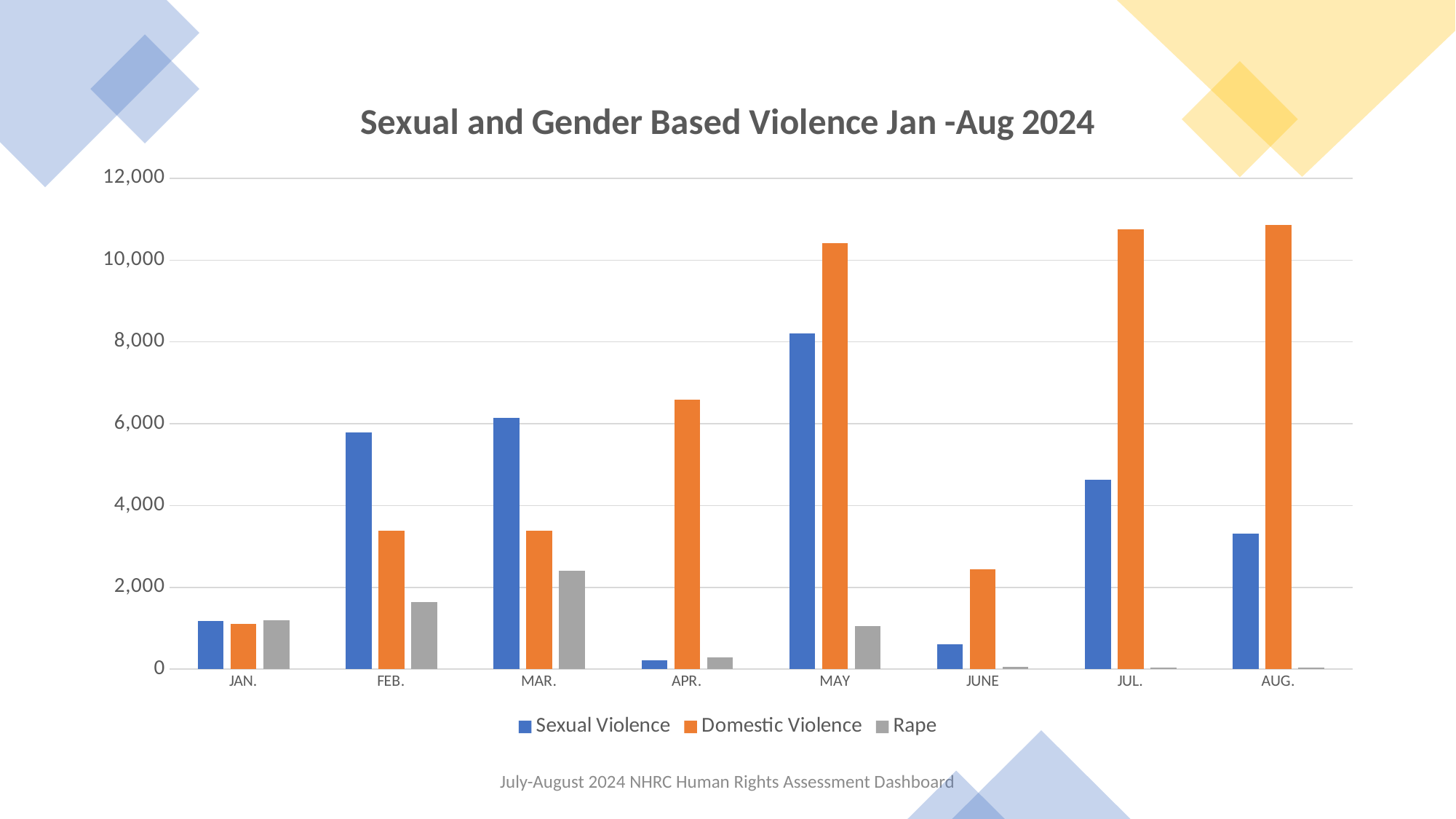
What is the title of the chart? Sexual and Gender Based Violence Jan -Aug 2024 Is the Domestic Violence value for APR. greater or less than 6,000? greater In FEB., which is larger: Sexual Violence or Domestic Violence? Sexual Violence How many months are shown on the x axis? 8 Is the Sexual Violence value for MAY greater or less than 8,000? greater How many series does the legend list? 3 In which month is the Sexual Violence value lowest? APR. In which month is the Rape value highest? MAR. In which month is the Domestic Violence value lowest? JAN. What kind of chart is shown on the slide? bar chart Is the Sexual Violence value for AUG. greater or less than 4,000? less In which month is the Sexual Violence value highest? MAY